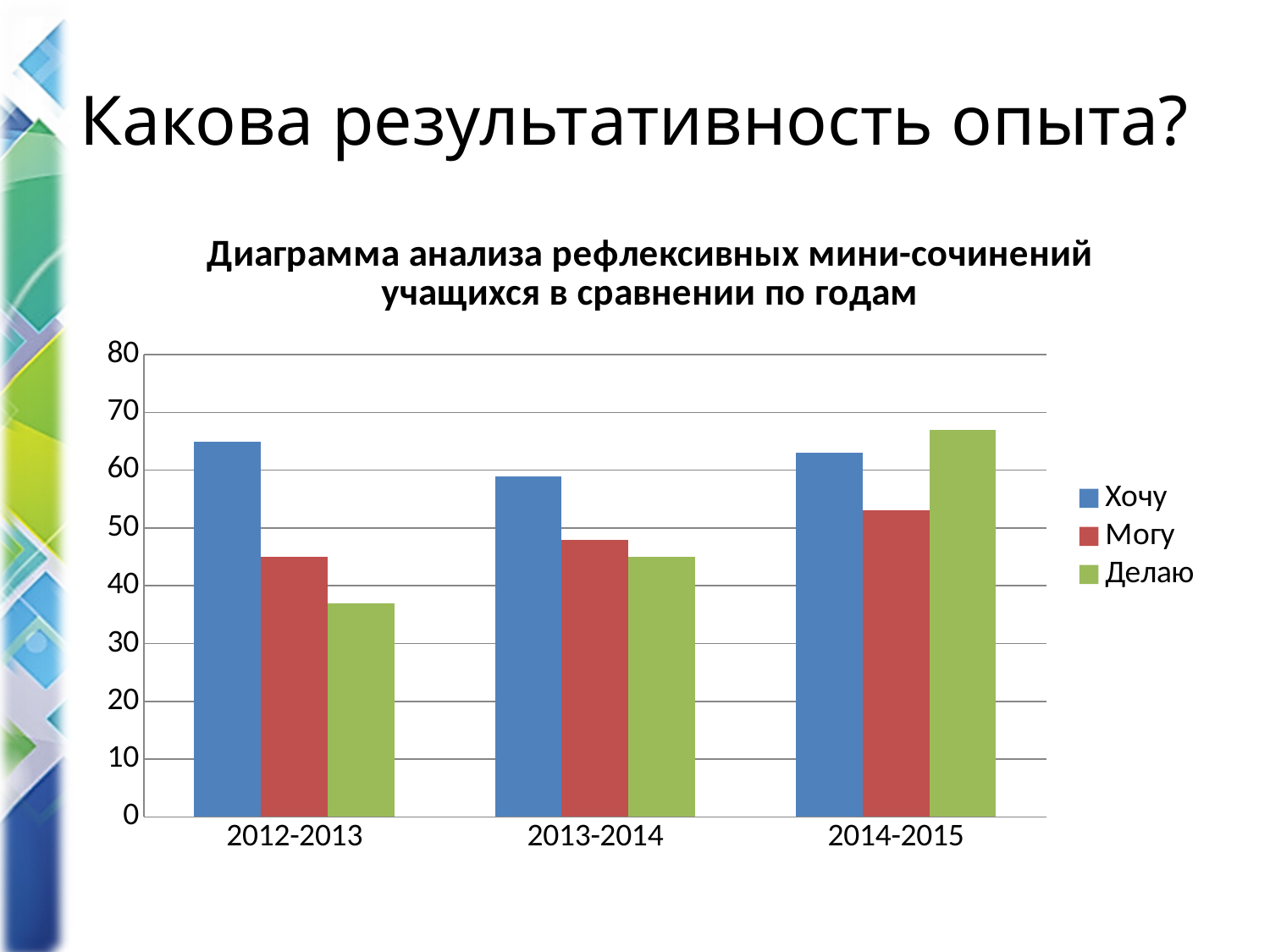
Is the value for Делаю in 2014-2015 greater or less than 60? greater Which colour represents the Могу series in the legend? red How many series does the legend list? 3 Is the value for Хочу in 2012-2013 greater or less than 60? greater How many year categories are shown on the x axis? 3 Which series has the highest value in 2014-2015? Делаю Is the value for Делаю in 2012-2013 greater or less than 40? less Which series has the lowest value in 2012-2013? Делаю Which series has the highest value in 2012-2013? Хочу Does the value for Делаю rise or fall from 2012-2013 to 2014-2015? rise What kind of chart is shown on the slide? bar chart